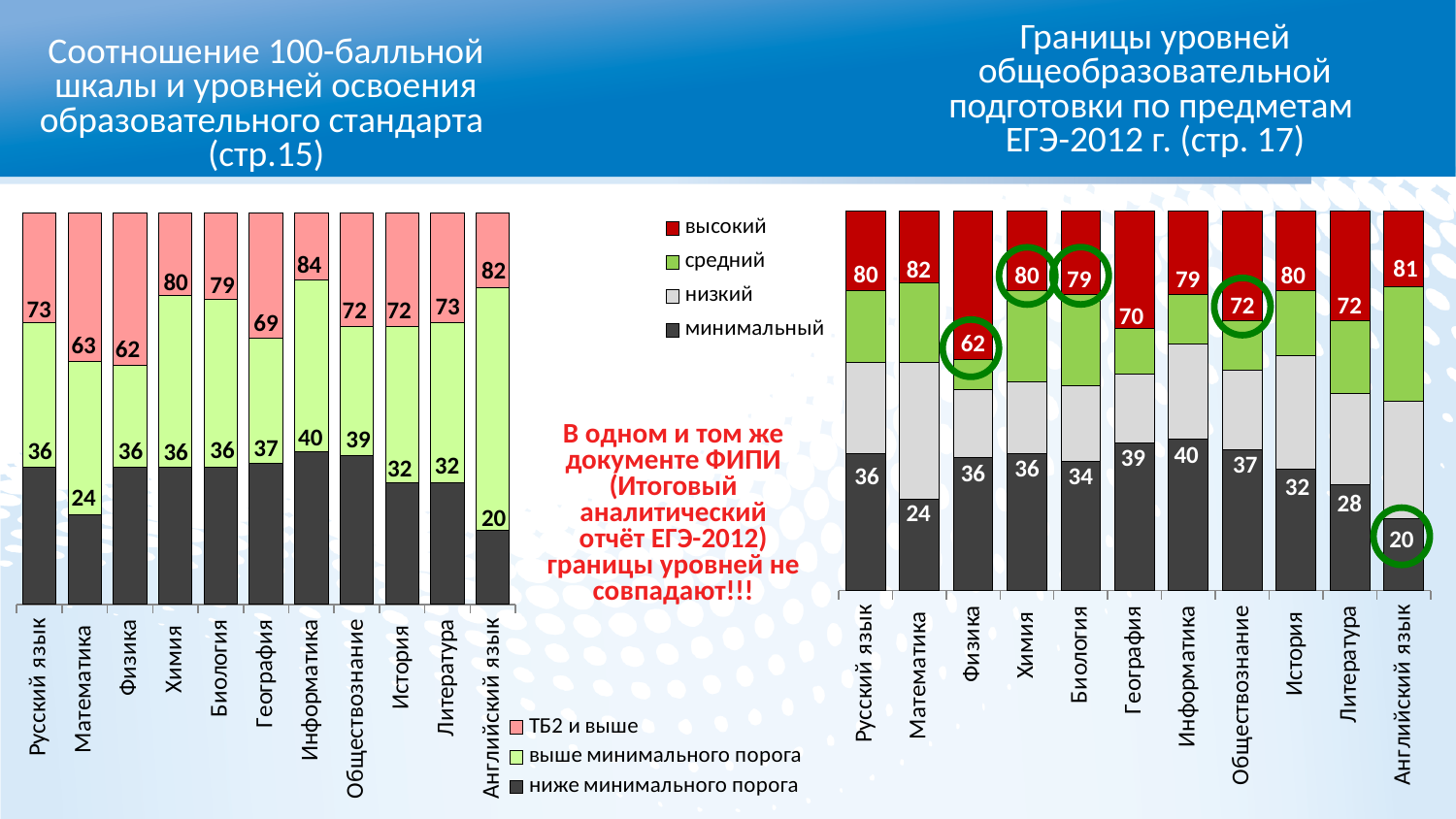
How many series does the legend of the right chart (стр. 17) list? 4 Which is larger: the upper labelled value for История on the left chart or on the right chart? Right chart (80) On the right chart (стр. 17), what is the upper labelled value for Физика? 62 On the left chart (стр.15), which subject has the highest upper labelled value? Информатика On the left chart (стр.15), which subject has the lowest labelled value for the lower boundary? Английский язык On the left chart (стр.15), what is the upper labelled value for Информатика? 84 What is the difference between the lower labelled value for Биология on the left chart (36) and on the right chart (34)? 2 How many subjects are shown on the right chart (стр. 17)? 11 On the left chart (стр.15), what value is labelled at the top of the lower segment for Математика? 24 What type of chart is the left chart (стр.15)? Stacked bar chart On the right chart (стр. 17), what is the lower labelled value for Литература? 28 On the right chart (стр. 17), which subject has the lowest upper labelled value? Физика